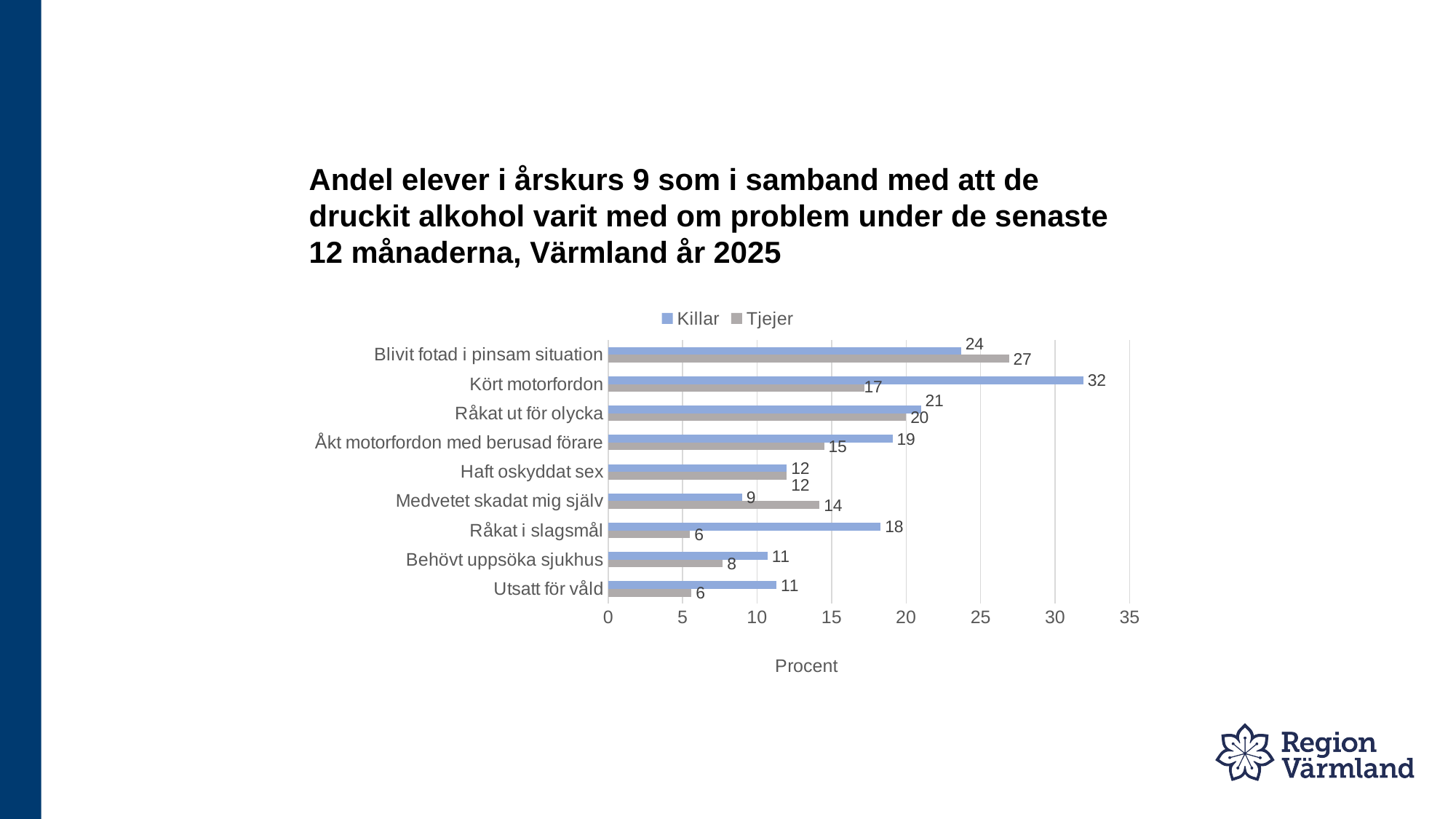
What is the value for Killar in the category "Kört motorfordon"? 32 What is the difference between Killar and Tjejer for "Kört motorfordon"? 15 What is the difference between Killar and Tjejer for "Råkat i slagsmål"? 12 For "Medvetet skadat mig själv", which series has the larger value, Killar or Tjejer? Tjejer What kind of chart is shown on the slide? Bar chart Which category has the lowest value for Killar? Medvetet skadat mig själv Which category has the highest value for Tjejer? Blivit fotad i pinsam situation Which category has the highest value for Killar? Kört motorfordon How many series does the legend list? 2 What is the value for Tjejer in the category "Blivit fotad i pinsam situation"? 27 How many categories are shown in the chart? 9 What is the value for Killar in the category "Haft oskyddat sex"? 12